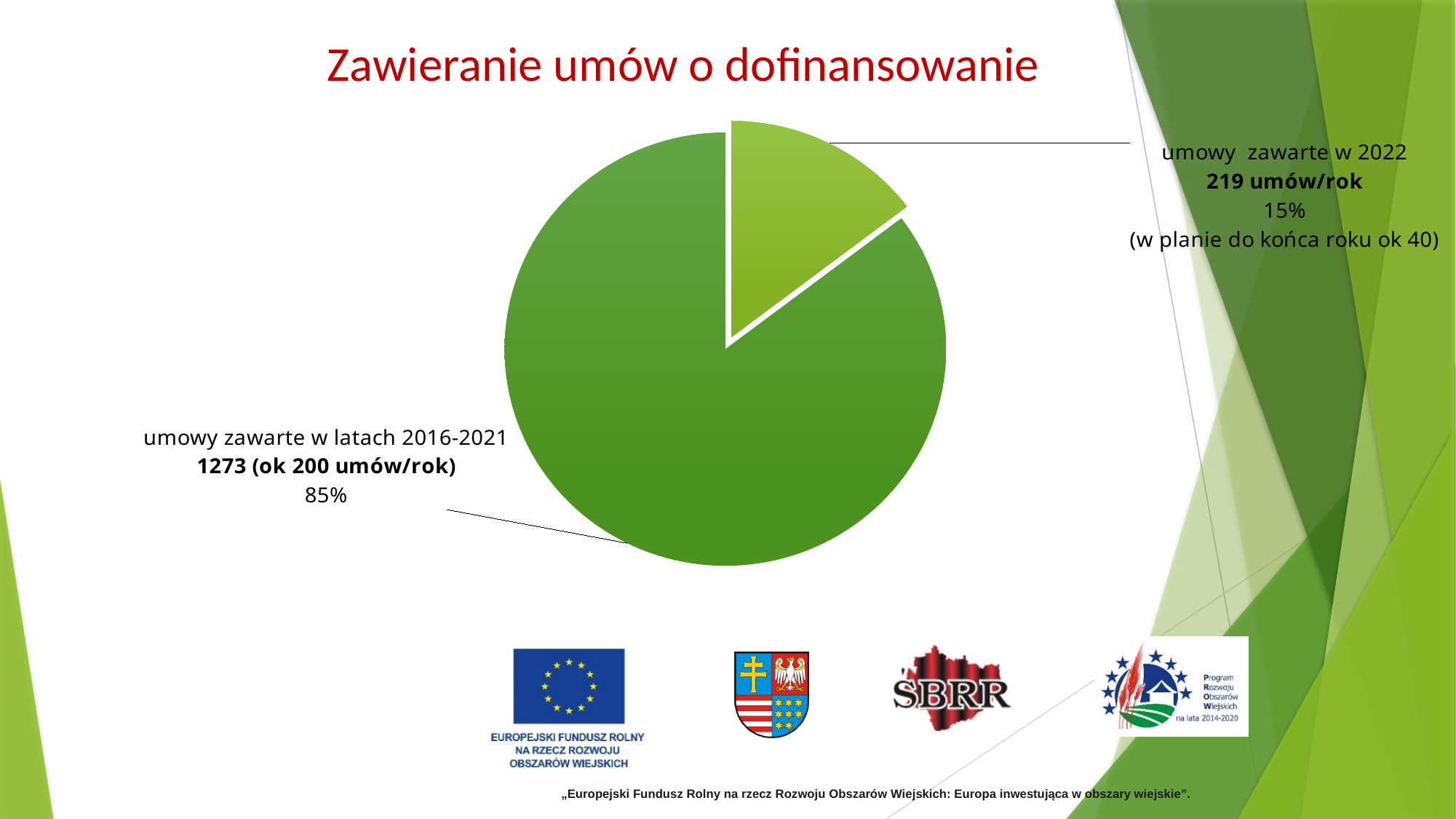
How many slices does the pie chart have? 2 What kind of chart is shown on the slide? pie chart What is the difference in percentage points between the 2016-2021 slice and the 2022 slice? 70 What is the total number of contracts across both slices of the pie? 1492 How many contracts are shown for "umowy zawarte w 2022"? 219 Which is larger: the number of contracts for 2016-2021 or for 2022? 2016-2021 What share of the pie is labelled "umowy zawarte w 2022"? 15% Which slice of the pie is the largest? umowy zawarte w latach 2016-2021 How many contracts are shown for "umowy zawarte w latach 2016-2021"? 1273 Which slice of the pie is the smallest? umowy zawarte w 2022 What share of the pie is labelled "umowy zawarte w latach 2016-2021"? 85% What is the title of the chart on the slide? Zawieranie umów o dofinansowanie